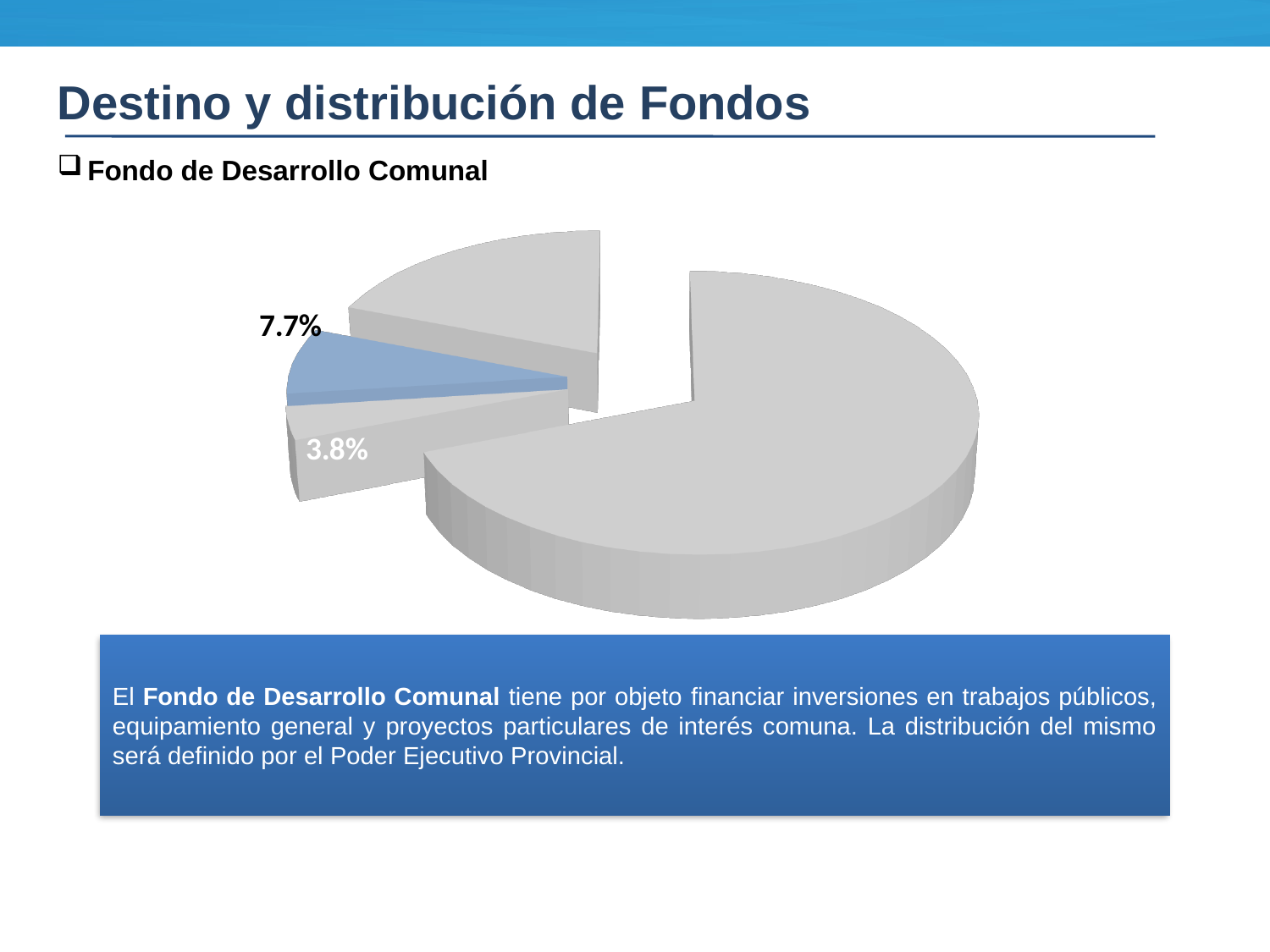
Is the value of the smallest slice greater or less than 5%? less What colour is the slice labelled 7.7%? blue How many slices of the pie chart have a printed percentage label? 2 What is the difference between the 7.7% slice and the 3.8% slice? 3.9% Which is larger, the blue slice or the slice labelled 3.8%? the blue slice Is the value of the blue slice greater or less than 5%? greater How many slices does the pie chart have? 4 Which fund does the pie chart on the slide refer to? Fondo de Desarrollo Comunal What percentage is shown for the blue slice of the pie chart? 7.7% What kind of chart is shown on the slide? pie chart What percentage is shown for the smallest slice of the pie chart? 3.8%